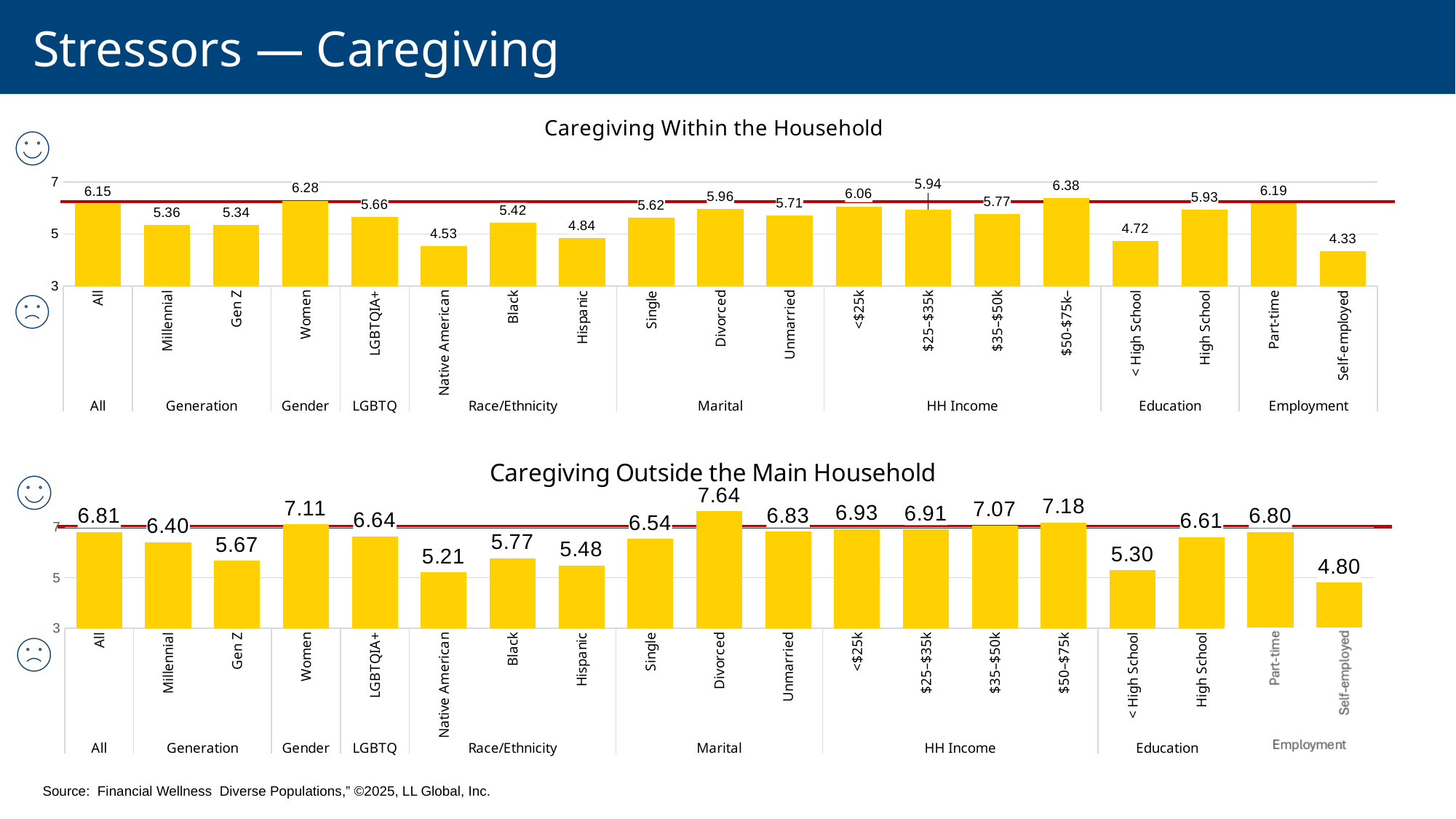
In the 'Caregiving Outside the Main Household' chart, what is the value for Divorced? 7.64 In the 'Caregiving Outside the Main Household' chart, which category has the lowest value? Self-employed In the 'Caregiving Within the Household' chart, what is the value for Women? 6.28 In the 'Caregiving Within the Household' chart, which is larger, the value for Black or the value for Hispanic? Black In the 'Caregiving Outside the Main Household' chart, how many bars are plotted? 19 In the 'Caregiving Within the Household' chart, what is the difference between the values for Part-time and Self-employed? 1.86 In the 'Caregiving Outside the Main Household' chart, what is the difference between the values for Women and Native American? 1.90 In the 'Caregiving Within the Household' chart, which category has the lowest value? Self-employed What is the title of the lower chart on the slide? Caregiving Outside the Main Household In the 'Caregiving Outside the Main Household' chart, which category has the highest value? Divorced What kind of chart is 'Caregiving Within the Household'? Bar chart In the 'Caregiving Within the Household' chart, which category has the highest value? $50–$75k